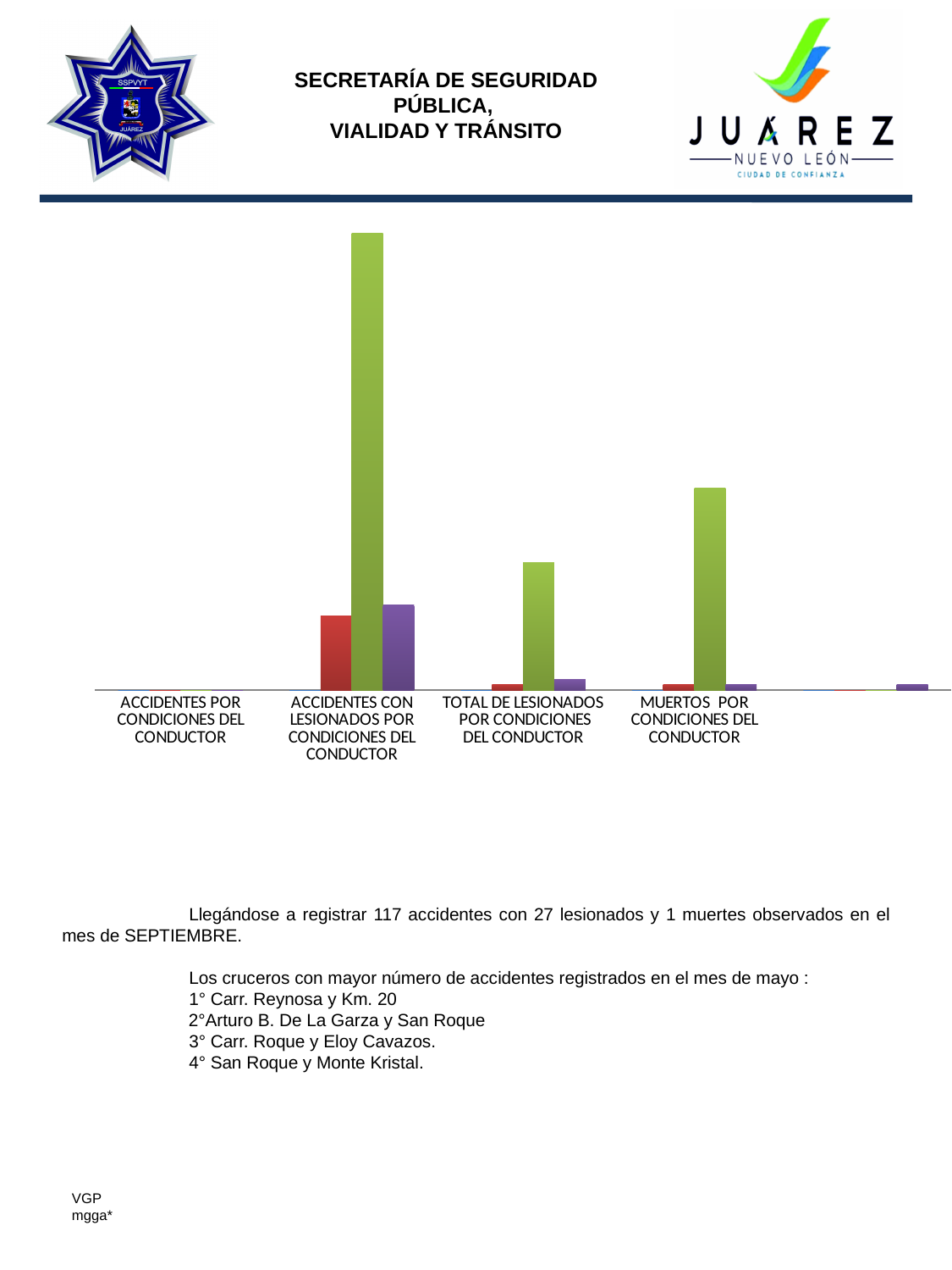
What kind of chart is shown on the slide? bar chart Is the green bar taller for ACCIDENTES CON LESIONADOS POR CONDICIONES DEL CONDUCTOR or for MUERTOS POR CONDICIONES DEL CONDUCTOR? ACCIDENTES CON LESIONADOS POR CONDICIONES DEL CONDUCTOR Does the chart display a legend? No Which labeled category shows no visible bars in the chart? ACCIDENTES POR CONDICIONES DEL CONDUCTOR Which category has the tallest bar in the chart? ACCIDENTES CON LESIONADOS POR CONDICIONES DEL CONDUCTOR Within the ACCIDENTES CON LESIONADOS POR CONDICIONES DEL CONDUCTOR category, which bar is taller, the red one or the purple one? the purple one Is the red bar taller for ACCIDENTES CON LESIONADOS POR CONDICIONES DEL CONDUCTOR or for TOTAL DE LESIONADOS POR CONDICIONES DEL CONDUCTOR? ACCIDENTES CON LESIONADOS POR CONDICIONES DEL CONDUCTOR How many labeled categories appear on the x axis of the chart? 4 How many different bar colours are used in the chart? 3